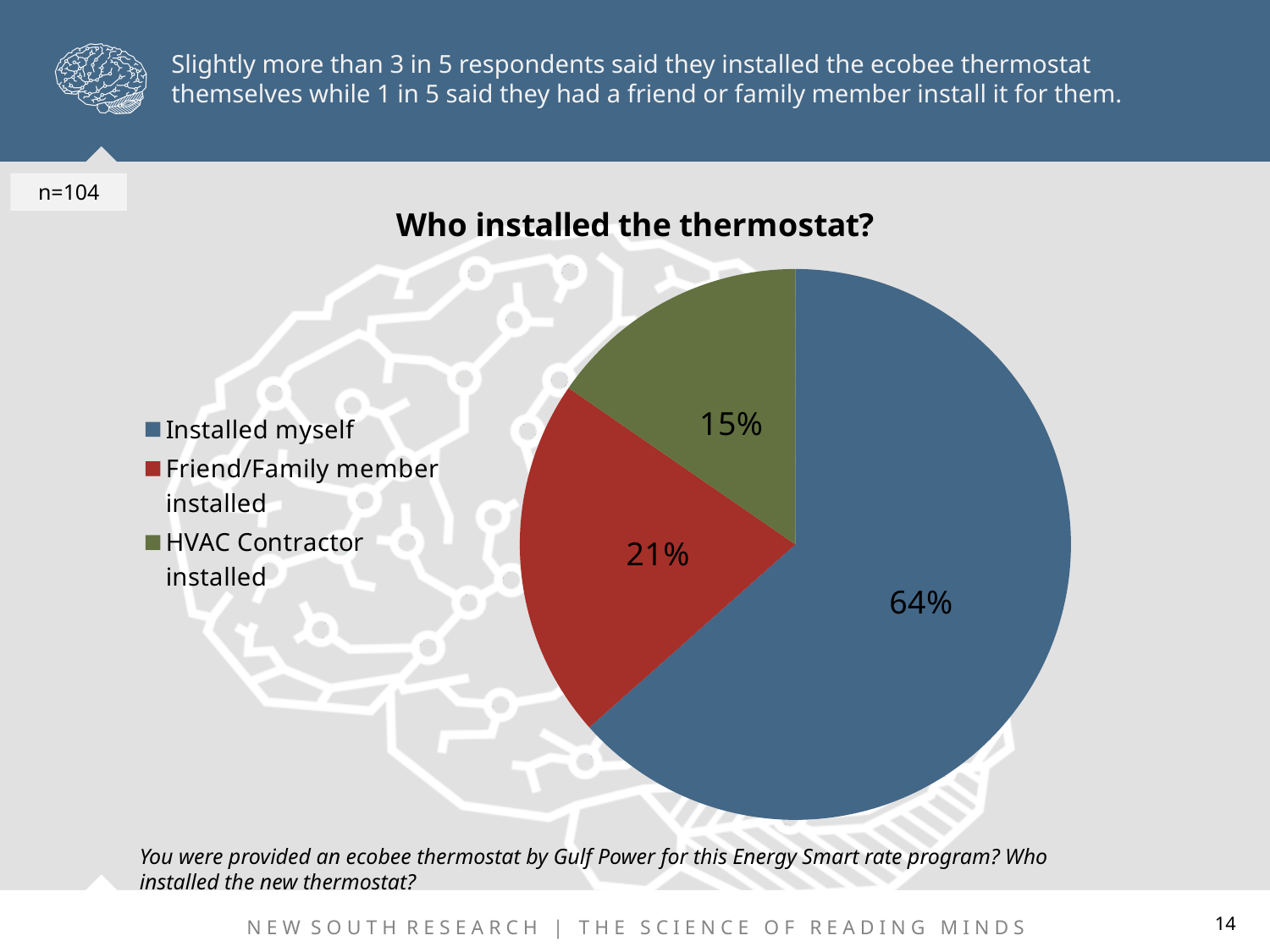
What is the title of the chart? Who installed the thermostat? Which category has the smallest slice of the pie? HVAC Contractor installed What share of respondents said a friend or family member installed the thermostat? 21% How many categories does the pie chart show? 3 What kind of chart is shown on the slide? Pie chart What colour is the slice for 'Installed myself'? Blue Which is larger: the share for 'Friend/Family member installed' or 'HVAC Contractor installed'? Friend/Family member installed What share of respondents said an HVAC contractor installed the thermostat? 15% What share of respondents said they installed the thermostat themselves? 64% What is the difference in percentage points between 'Installed myself' and 'Friend/Family member installed'? 43 percentage points What is the difference in percentage points between 'Friend/Family member installed' and 'HVAC Contractor installed'? 6 percentage points Which category has the largest slice of the pie? Installed myself